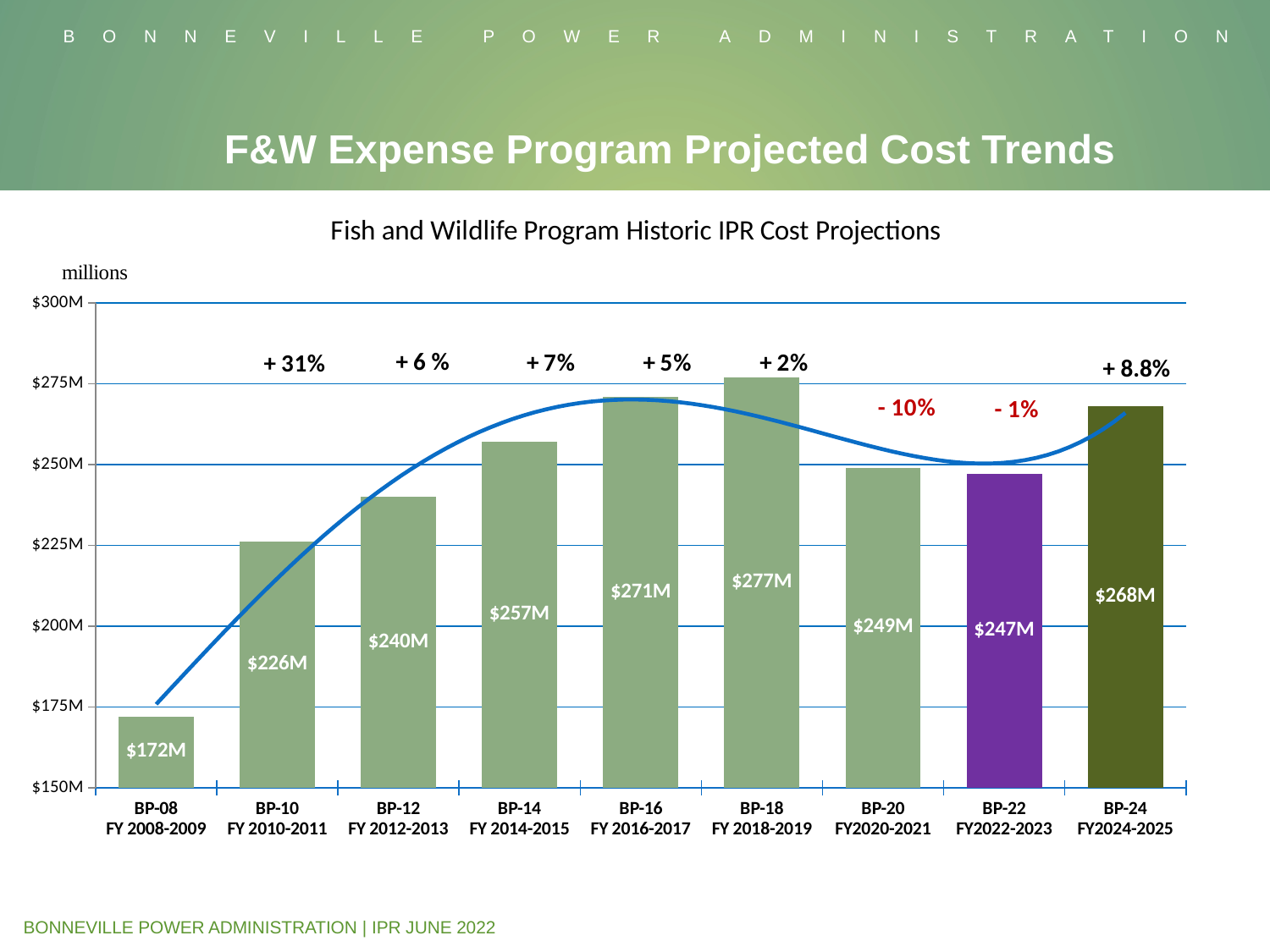
What is the title of the chart? Fish and Wildlife Program Historic IPR Cost Projections How many periods (bars) are shown on the chart? 9 Which period has the highest value? BP-18 (FY 2018-2019) What is the value for BP-22 (FY2022-2023)? $247M What percentage change is labeled above the BP-20 bar? - 10% Which period has the lowest value? BP-08 (FY 2008-2009) What is the value for BP-16 (FY 2016-2017)? $271M Which is larger, the value for BP-24 or the value for BP-14? BP-24 What kind of chart is this? bar chart Do the values rise or fall from BP-08 to BP-18? rise What is the difference between the values for BP-18 and BP-08? $105M Is the value for BP-12 greater or less than $250M? less